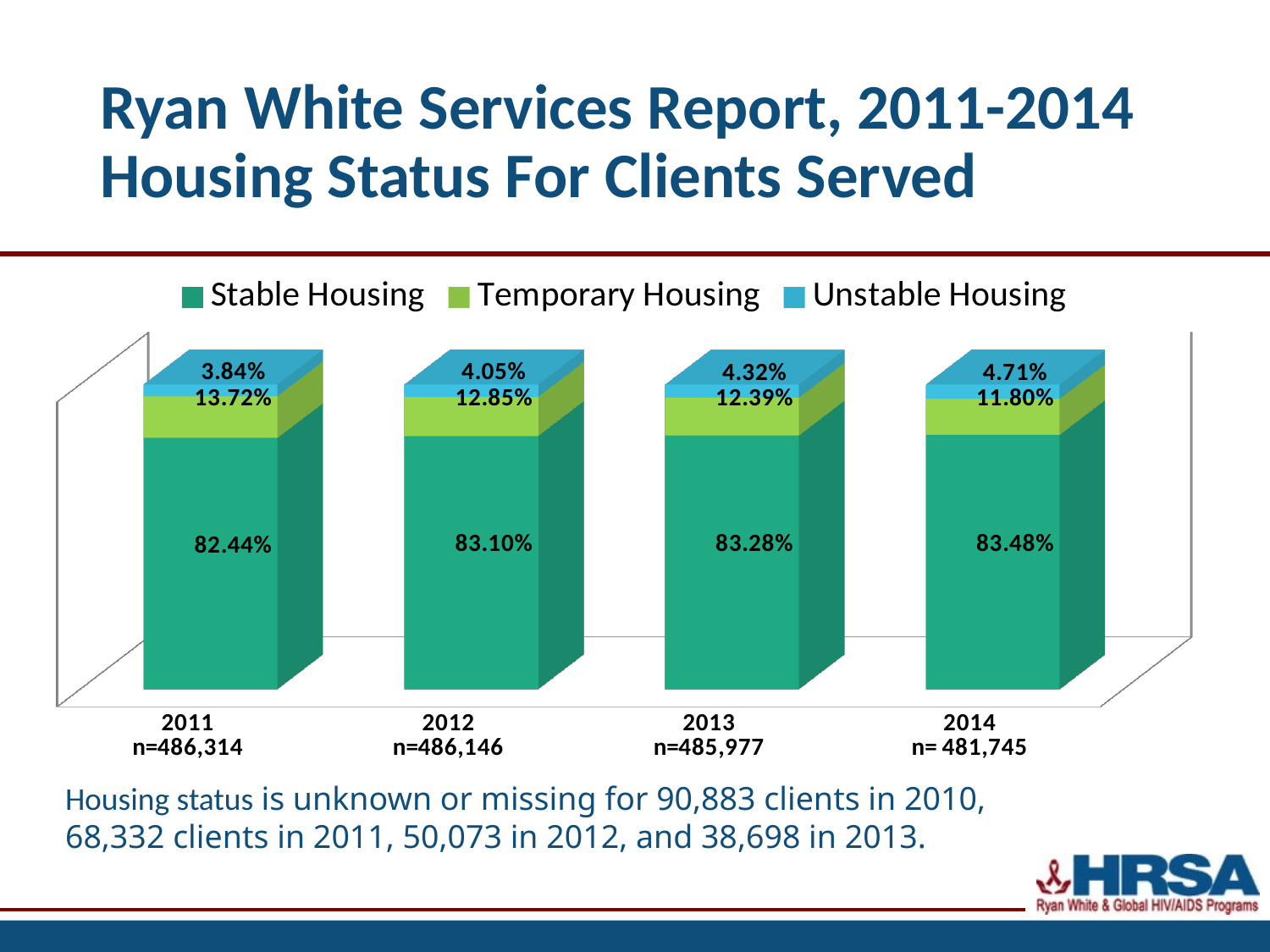
How many series does the legend list? 3 What percentage of clients were in Stable Housing in 2011? 82.44% What is the number of clients (n) shown for 2013? n=485,977 In which year was the Stable Housing percentage highest? 2014 What percentage of clients were in Unstable Housing in 2014? 4.71% What percentage of clients were in Temporary Housing in 2013? 12.39% What is the difference between the Temporary Housing percentages in 2011 and 2014? 1.92% Does the Temporary Housing percentage rise or fall from 2011 to 2014? Fall In which year was the Unstable Housing percentage lowest? 2011 Which is larger, the Unstable Housing percentage in 2012 or in 2013? 2013 How many years are shown on the x axis? 4 What kind of chart is shown on the slide? Stacked bar chart